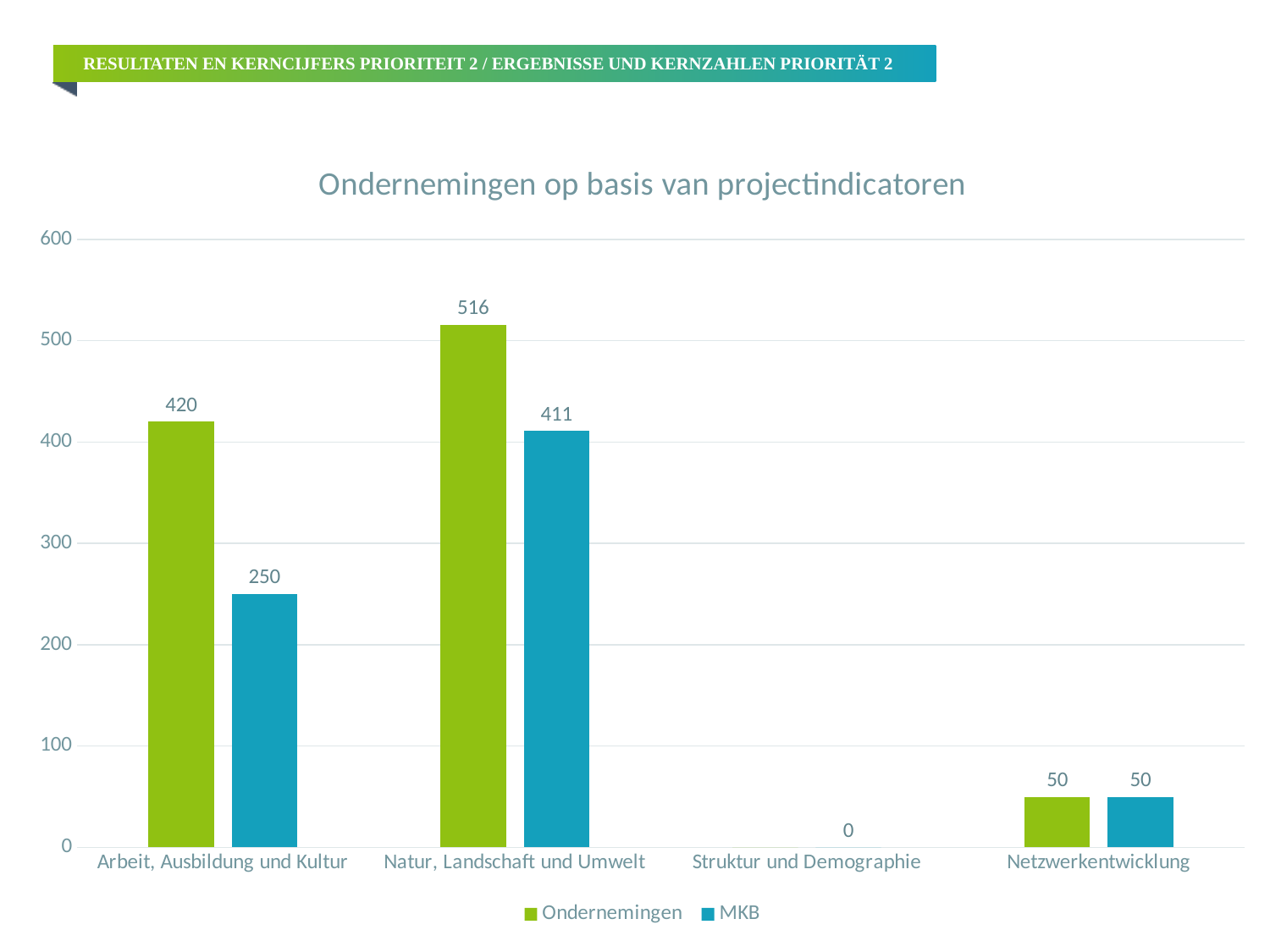
What is the MKB value for Netzwerkentwicklung? 50 What is the difference between the Ondernemingen values for Natur, Landschaft und Umwelt and Arbeit, Ausbildung und Kultur? 96 What is the MKB value for Arbeit, Ausbildung und Kultur? 250 What is the difference between the Ondernemingen and MKB values for Arbeit, Ausbildung und Kultur? 170 Which category has the highest Ondernemingen value? Natur, Landschaft und Umwelt Which category has the lowest MKB value? Struktur und Demographie Which is larger: the MKB value for Natur, Landschaft und Umwelt or the Ondernemingen value for Arbeit, Ausbildung und Kultur? Ondernemingen value for Arbeit, Ausbildung und Kultur What is the title of the chart? Ondernemingen op basis van projectindicatoren What kind of chart is shown on the slide? Bar chart How many series does the legend list? 2 What is the Ondernemingen value for Natur, Landschaft und Umwelt? 516 How many categories are shown on the x axis? 4